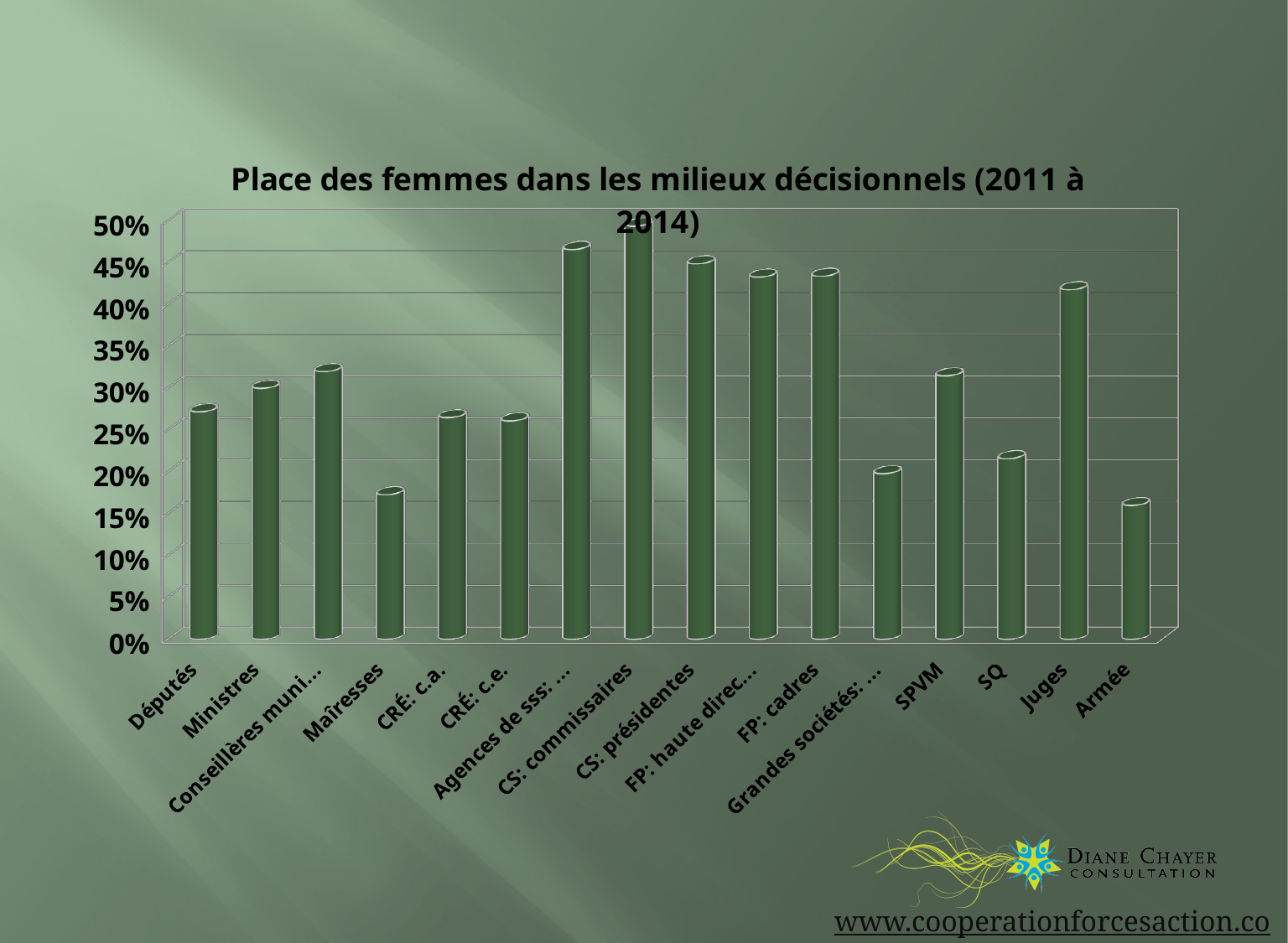
Which category has the highest value? CS: commissaires What is the title of the chart? Place des femmes dans les milieux décisionnels (2011 à 2014) Is the value for Juges greater or less than 40%? greater How many categories are plotted on the x axis? 16 What kind of chart is shown on the slide? bar chart Is the value for Agences de sss greater or less than 45%? greater Is the value for Armée greater or less than 20%? less Which is larger, the value for Ministres or the value for Maîresses? Ministres Which is larger, the value for Juges or the value for SQ? Juges Which is larger, the value for CS: présidentes or the value for Députés? CS: présidentes